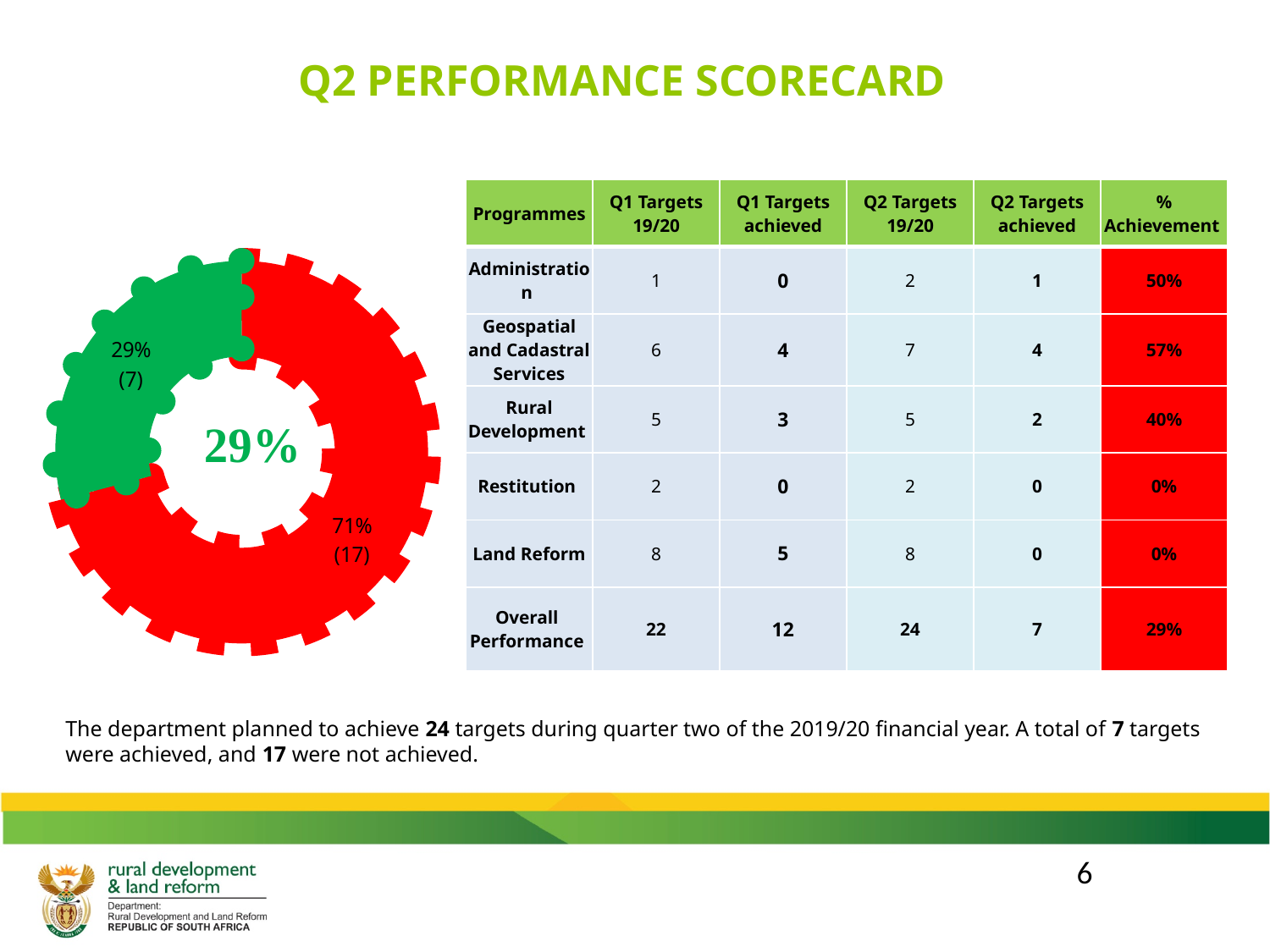
What colour is the smaller slice of the doughnut chart? green Which slice of the doughnut chart is larger, the green one or the red one? red What percentage is shown for the red slice of the doughnut chart? 71% What is the difference in percentage points between the red slice and the green slice of the doughnut chart? 42 What value is printed in the centre of the doughnut chart? 29% What percentage is shown for the green slice of the doughnut chart? 29% How many slices does the doughnut chart have? 2 What is the difference between the counts shown for the red slice and the green slice of the doughnut chart? 10 What count is shown in brackets for the green slice of the doughnut chart? 7 What kind of chart is shown on the left of the slide? doughnut chart What is the total of the counts shown for the two slices of the doughnut chart? 24 What count is shown in brackets for the red slice of the doughnut chart? 17